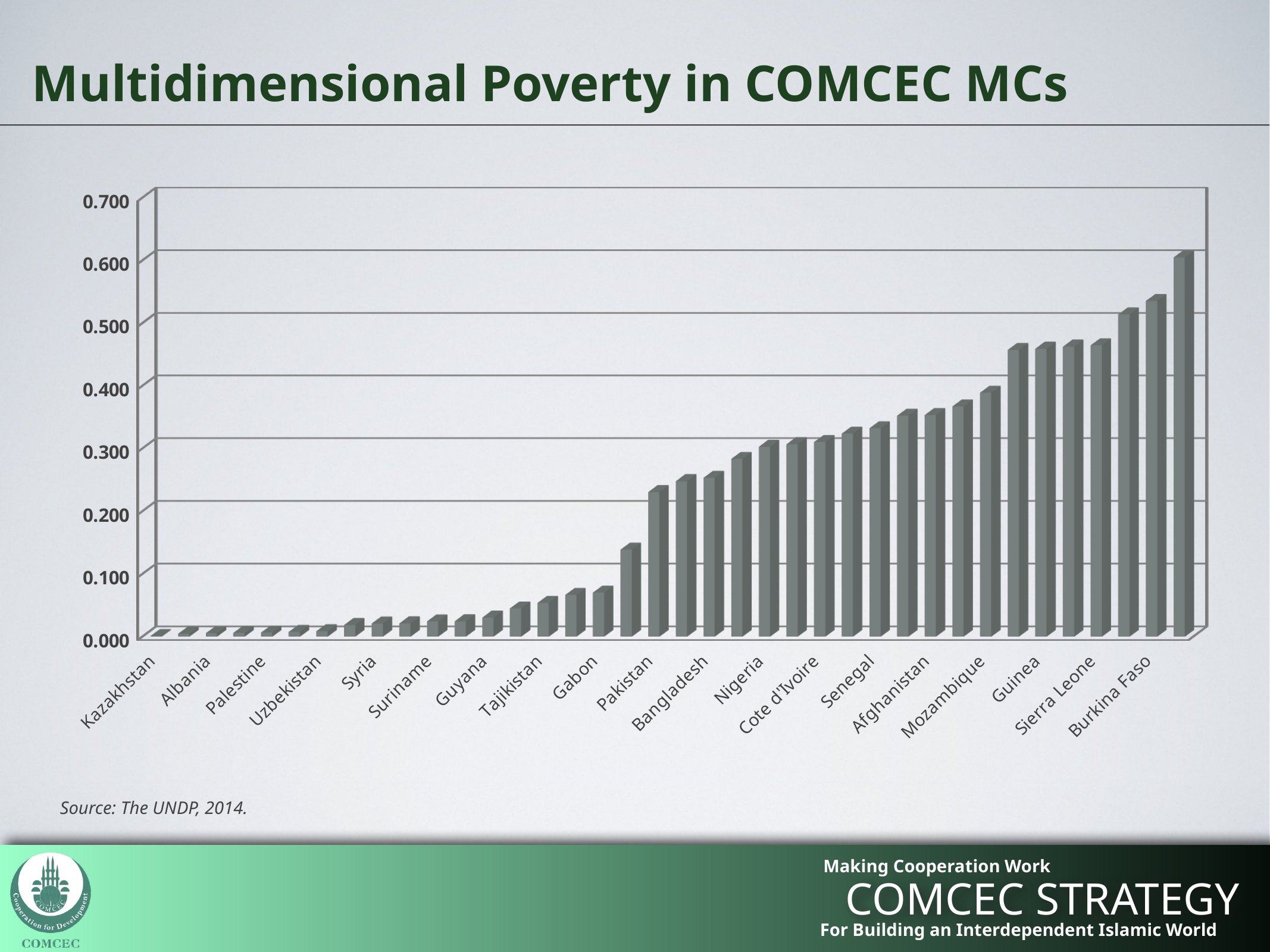
Is the value for Kazakhstan greater or less than 0.100? less Do the values generally rise or fall from left to right along the x axis? rise Is the value for Burkina Faso greater or less than 0.500? greater What source is cited for the chart? The UNDP, 2014. Which has the larger value, Guinea or Nigeria? Guinea Which has the larger value, Burkina Faso or Kazakhstan? Burkina Faso What is the title of the chart on the slide? Multidimensional Poverty in COMCEC MCs What kind of chart is shown on the slide? bar chart Is the value for Syria greater or less than 0.100? less Which labelled country has the lowest value in the chart? Kazakhstan